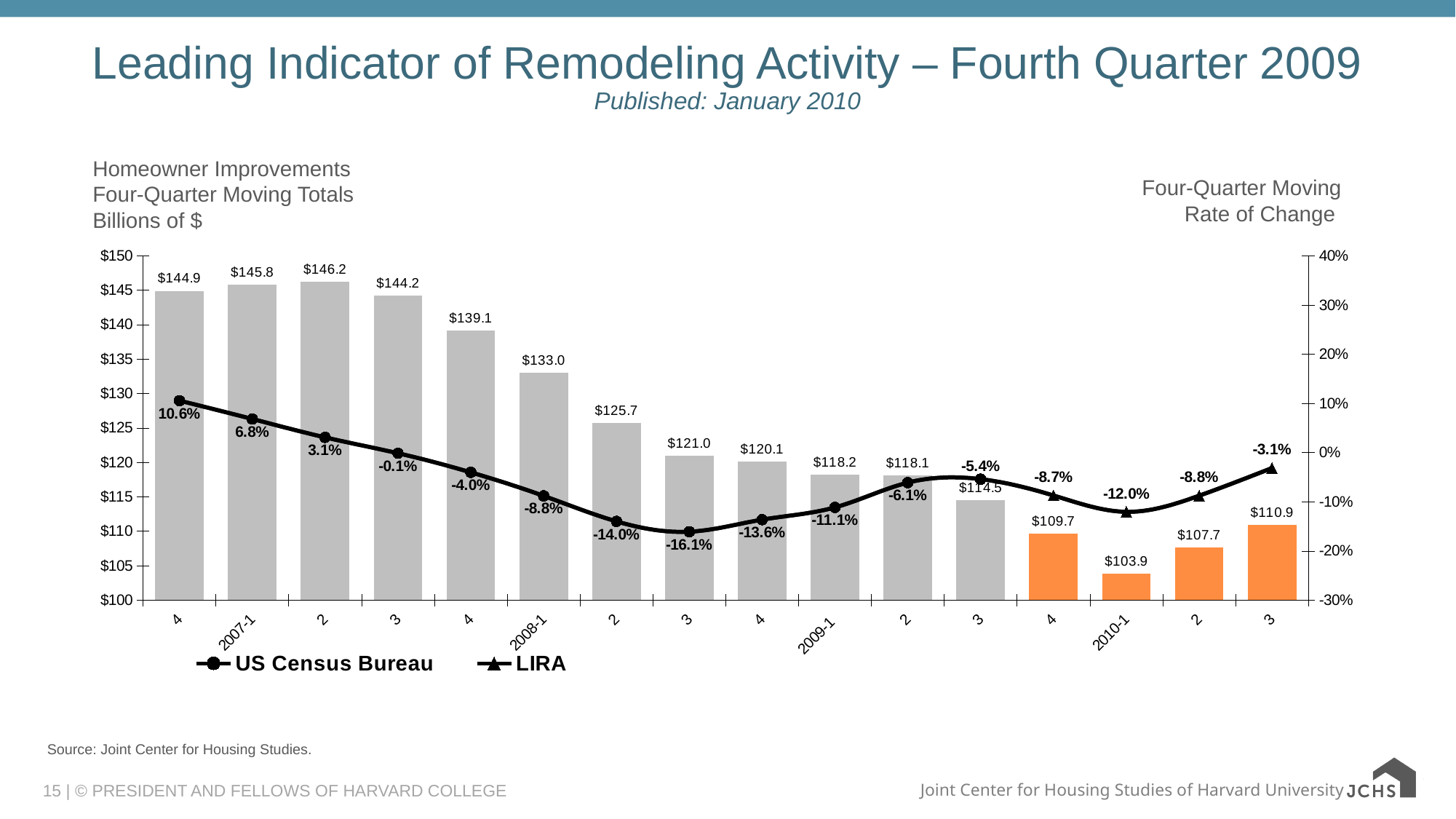
Which is larger, the four-quarter moving total for 2008-2 or for 2008-3? 2008-2 ($125.7) What is the LIRA four-quarter moving rate of change for 2010-1? -12.0% How many series does the legend list? 2 What is the US Census Bureau four-quarter moving rate of change for 2008-3? -16.1% Which quarter has the lowest four-quarter moving total bar? 2010-1 ($103.9) What kind of chart is shown on the slide? Combination bar and line chart What is the difference between the highest bar ($146.2 in 2007-2) and the lowest bar ($103.9 in 2010-1)? $42.3 Which quarter has the highest four-quarter moving total bar? 2007-2 ($146.2) Do the four-quarter moving total bars rise or fall from 2007-2 to 2010-1? Fall How many bars (quarters) are plotted in the chart? 16 Which quarters are shown with orange bars instead of gray? 2009-4, 2010-1, 2010-2 and 2010-3 What is the four-quarter moving total of homeowner improvements for 2008-1? $133.0